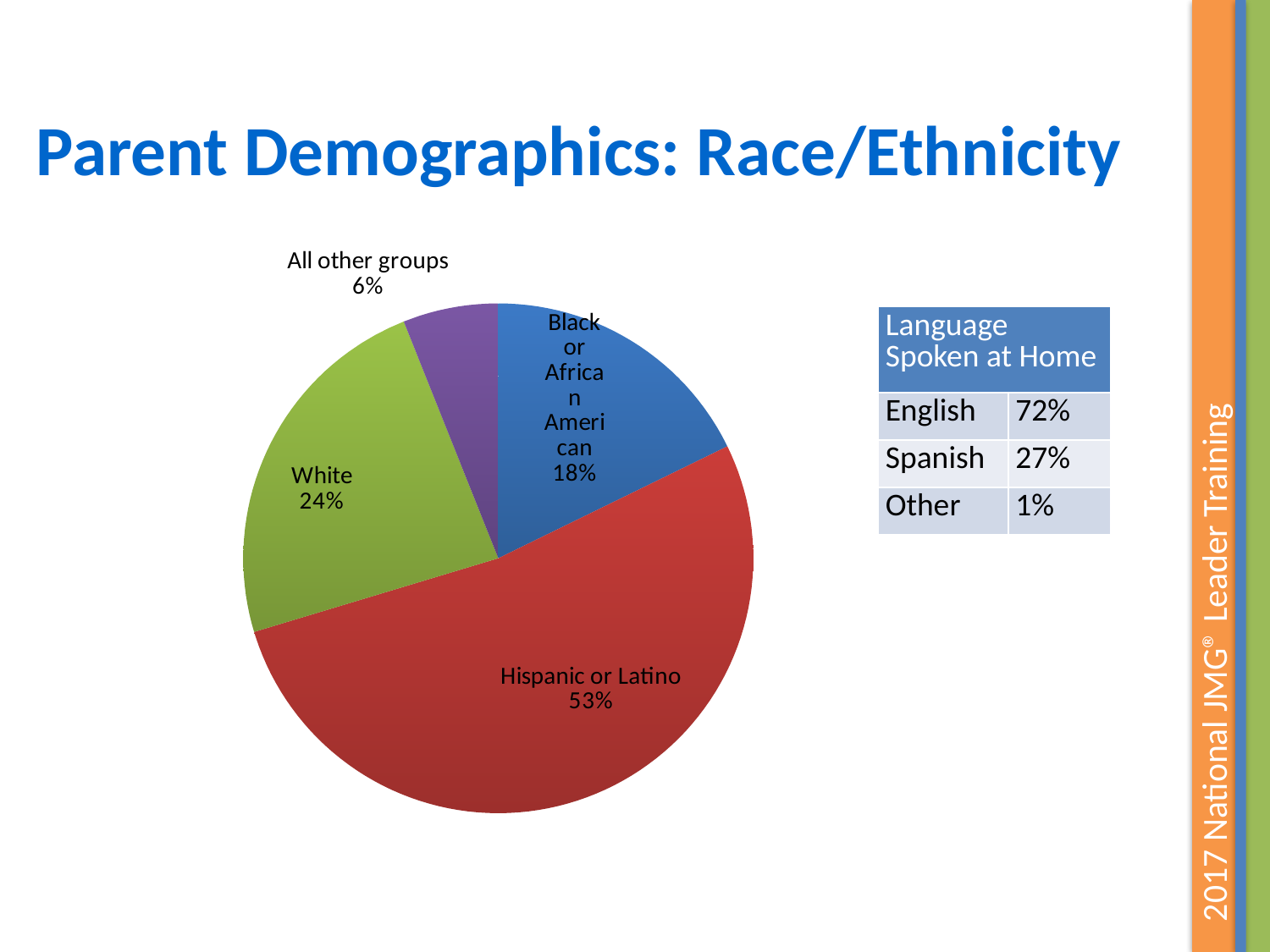
How many slices does the pie chart have? 4 What percentage of the pie chart is White? 24% Which group has the smallest slice of the pie chart? All other groups What percentage of the pie chart is Black or African American? 18% What percentage of the pie chart is All other groups? 6% What percentage of the pie chart is Hispanic or Latino? 53% What colour is the Hispanic or Latino slice of the pie chart? red Which slice is larger, White or Black or African American? White What kind of chart is shown on the slide? pie chart Which group has the largest slice of the pie chart? Hispanic or Latino What is the difference in percentage points between the Hispanic or Latino slice and the White slice? 29 What is the difference in percentage points between the White slice and the All other groups slice? 18